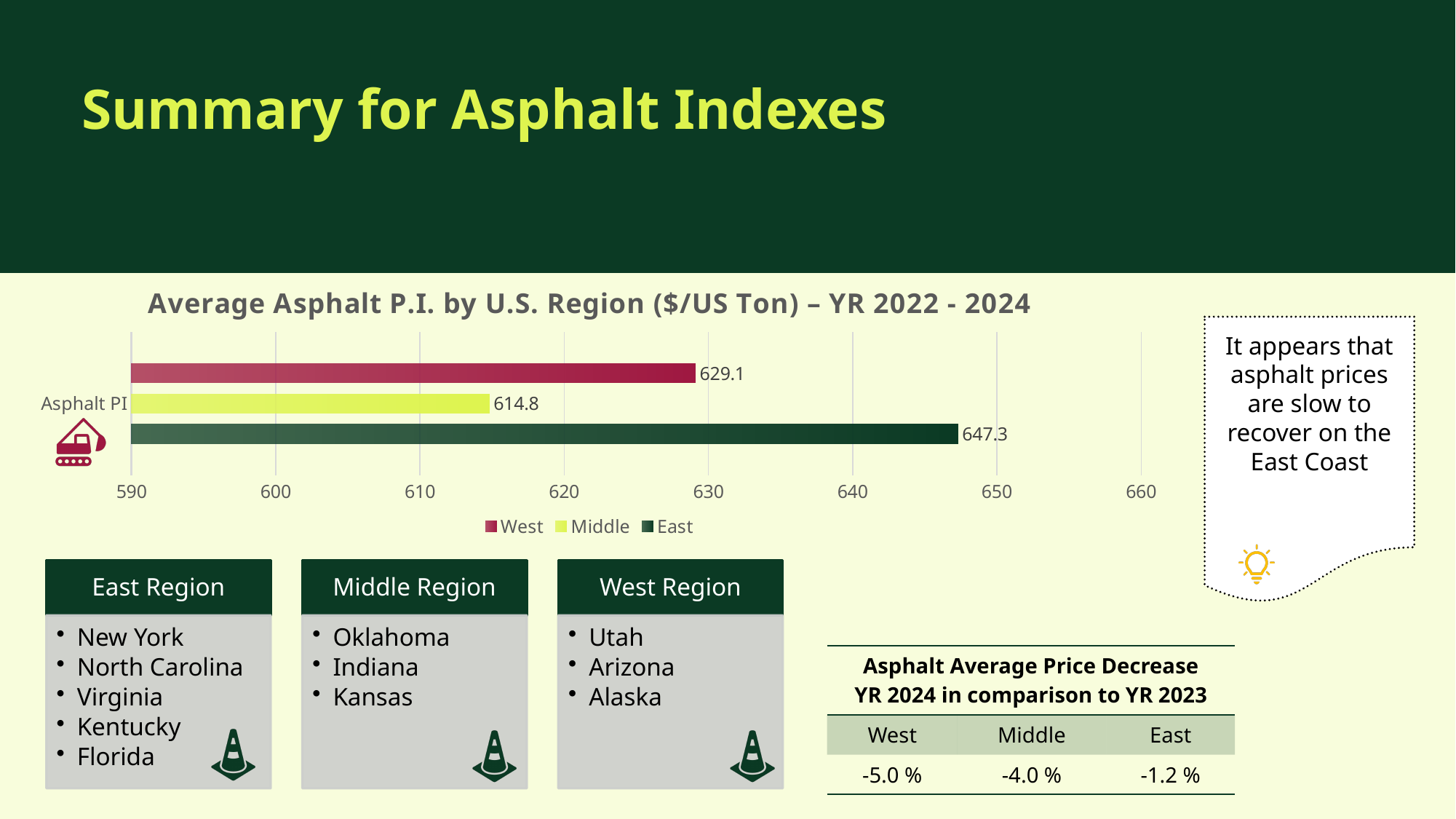
Is the value for the Middle series in the Average Asphalt P.I. chart greater or less than 620? less What is the difference between the West and Middle values in the Average Asphalt P.I. chart? 14.3 What is the value of the East series in the Average Asphalt P.I. chart? 647.3 What kind of chart is the Average Asphalt P.I. by U.S. Region chart? Bar chart Which region has the highest Average Asphalt P.I. in the chart? East What is the value of the West series in the Average Asphalt P.I. chart? 629.1 Which region has the lowest Average Asphalt P.I. in the chart? Middle What is the title of the chart on the slide? Average Asphalt P.I. by U.S. Region ($/US Ton) – YR 2022 - 2024 Which is larger in the Average Asphalt P.I. chart, the West value or the East value? East How many series does the legend of the Average Asphalt P.I. chart list? 3 What is the value of the Middle series in the Average Asphalt P.I. chart? 614.8 What is the difference between the East and Middle values in the Average Asphalt P.I. chart? 32.5